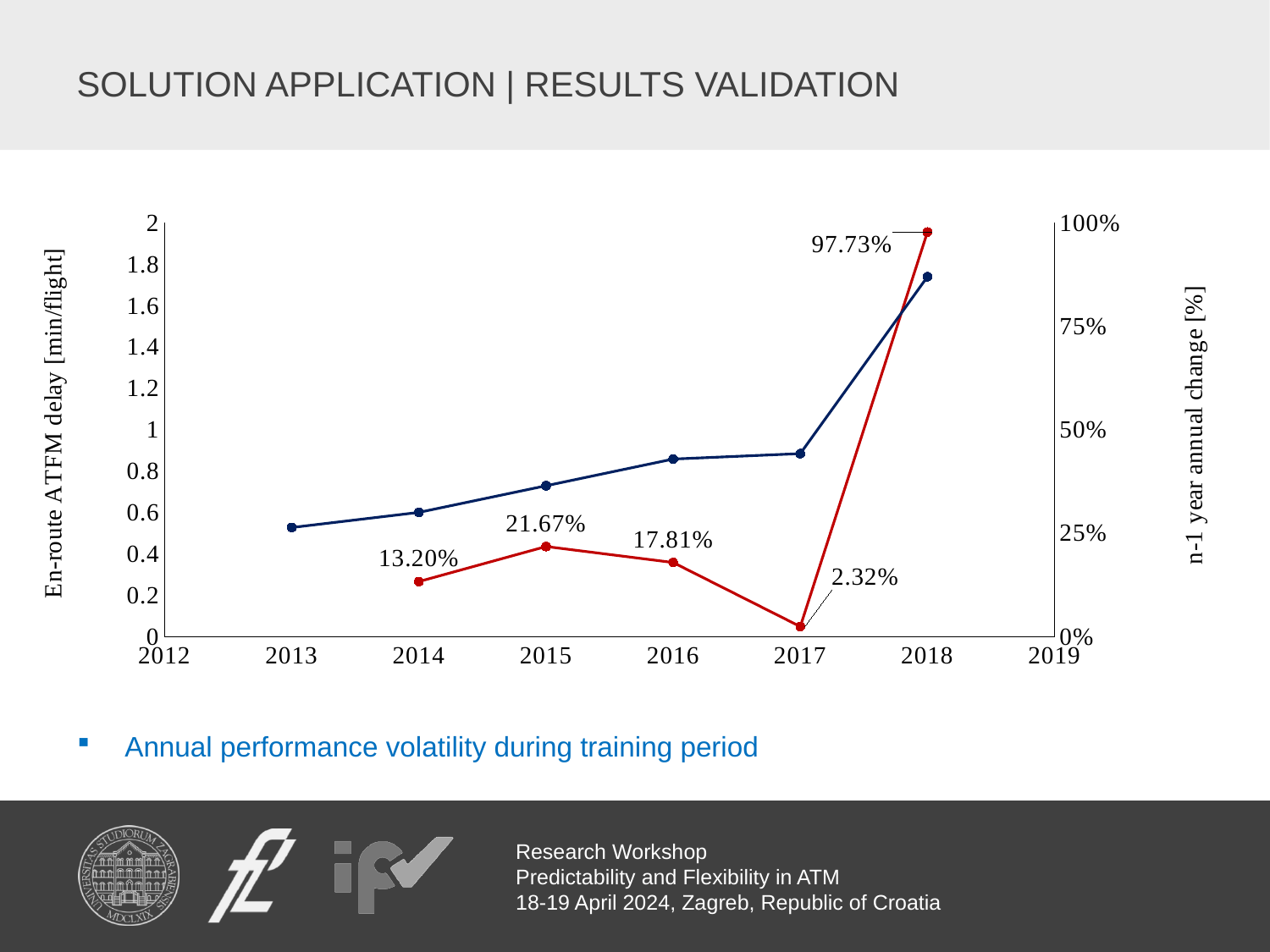
Is the en-route ATFM delay (blue line) for 2018 greater or less than 1.6 min/flight? greater What is the n-1 year annual change value labelled on the red line for 2018? 97.73% How many data points are labelled with percentages on the red line? 5 In which year does the red line (n-1 year annual change) reach its lowest value? 2017 What is the n-1 year annual change value labelled on the red line for 2014? 13.20% What is the n-1 year annual change value labelled on the red line for 2017? 2.32% What type of chart is shown on the slide? Line chart Is the en-route ATFM delay (blue line) for 2013 greater or less than 0.6 min/flight? less In which year does the red line (n-1 year annual change) reach its highest value? 2018 What is the difference between the red line's labelled values for 2015 and 2016? 3.86% Does the en-route ATFM delay (blue line) rise or fall from 2013 to 2018? Rises Which year has the larger labelled n-1 year annual change on the red line, 2015 or 2016? 2015